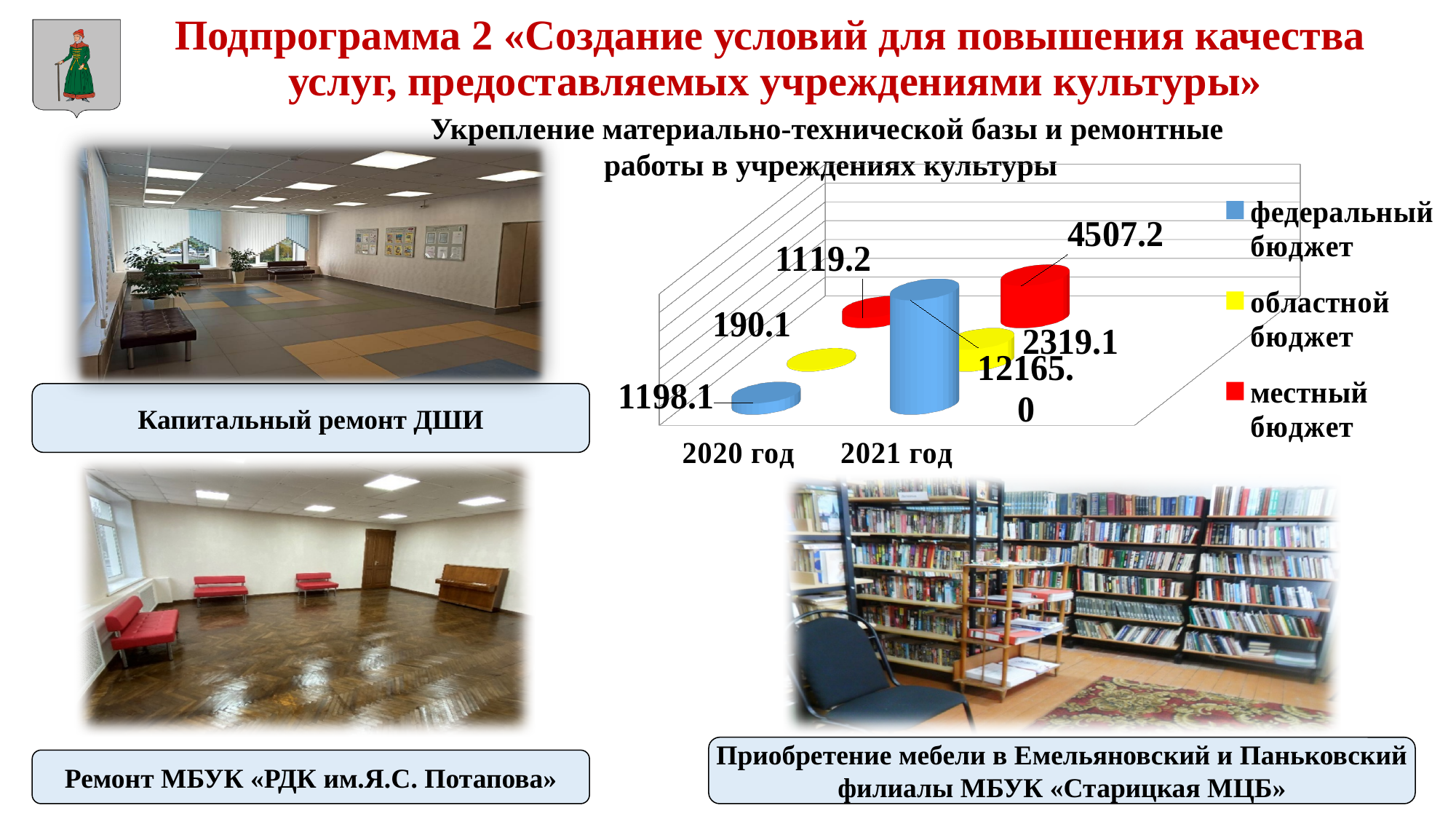
Which series has the lowest value in 2020 год? областной бюджет How many year categories are shown on the chart's x axis? 2 What is the difference between the местный бюджет values for 2021 год and 2020 год? 3388.0 What is the value for местный бюджет in 2021 год? 4507.2 What is the value for местный бюджет in 2020 год? 1119.2 Which is larger: областной бюджет in 2021 год or местный бюджет in 2021 год? местный бюджет in 2021 год How many series does the chart legend list? 3 Which series has the highest value in 2021 год? федеральный бюджет What is the value for областной бюджет in 2020 год? 190.1 What is the value for федеральный бюджет in 2021 год? 12165.0 What kind of chart is shown on the slide? bar chart What is the value for федеральный бюджет in 2020 год? 1198.1